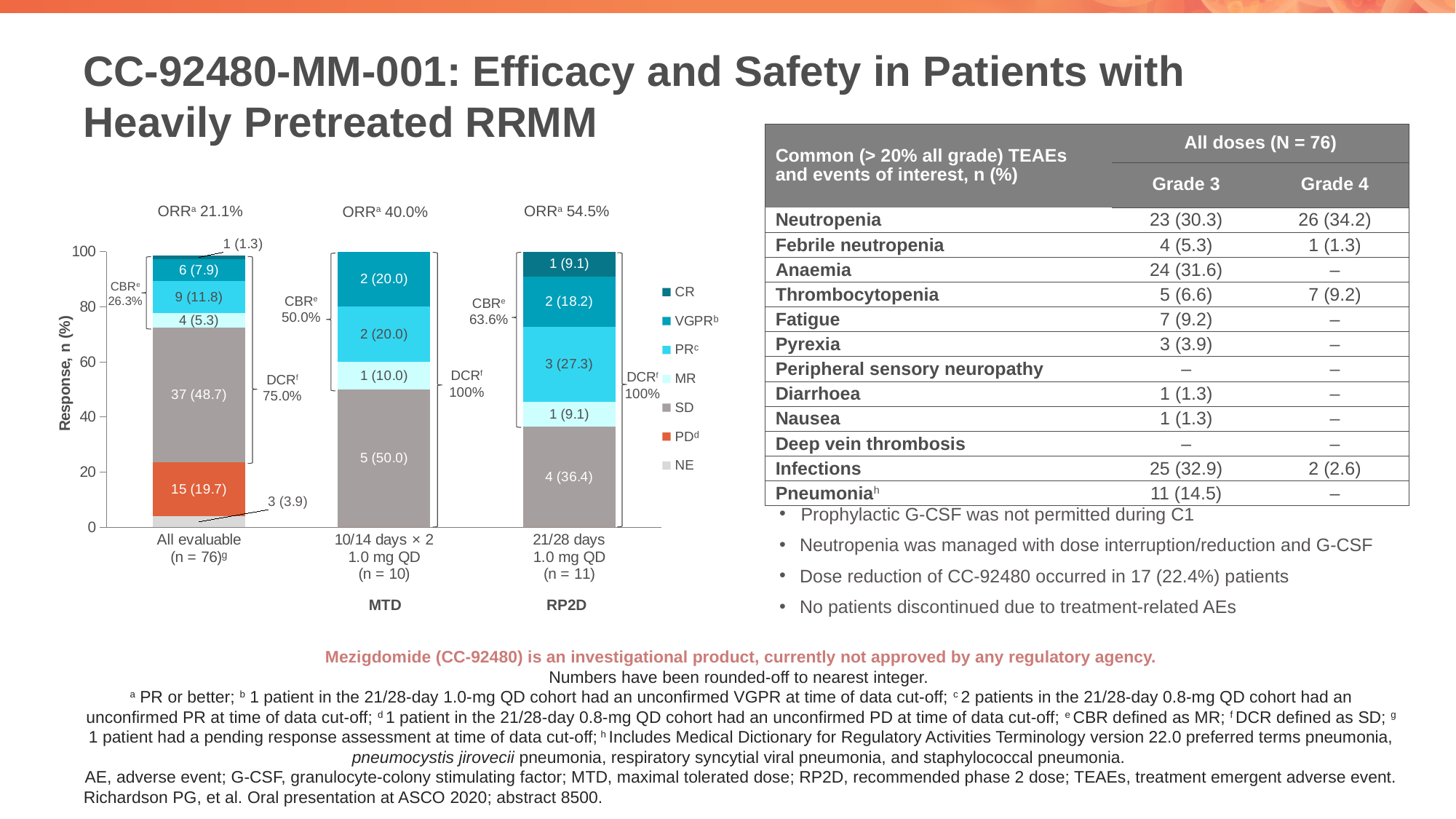
How many series does the chart legend list? 7 What is the data label for the PD segment in the All evaluable (n = 76) bar? 15 (19.7) What is the ORR shown above the 10/14 days × 2 1.0 mg QD (MTD) bar? 40.0% What is the difference in ORR between the RP2D cohort (54.5%) and the All evaluable cohort (21.1%)? 33.4 percentage points What kind of chart is shown on the slide? Stacked bar chart How many cohorts (bars) are plotted in the chart? 3 What is the data label for the PR segment in the 21/28 days 1.0 mg QD (RP2D) bar? 3 (27.3) What is the label of the chart's y axis? Response, n (%) Which bar has the larger SD percentage, the MTD bar or the RP2D bar? MTD (50.0%) What is the data label for the SD segment in the All evaluable (n = 76) bar? 37 (48.7) Which cohort has the highest ORR? 21/28 days 1.0 mg QD (RP2D)